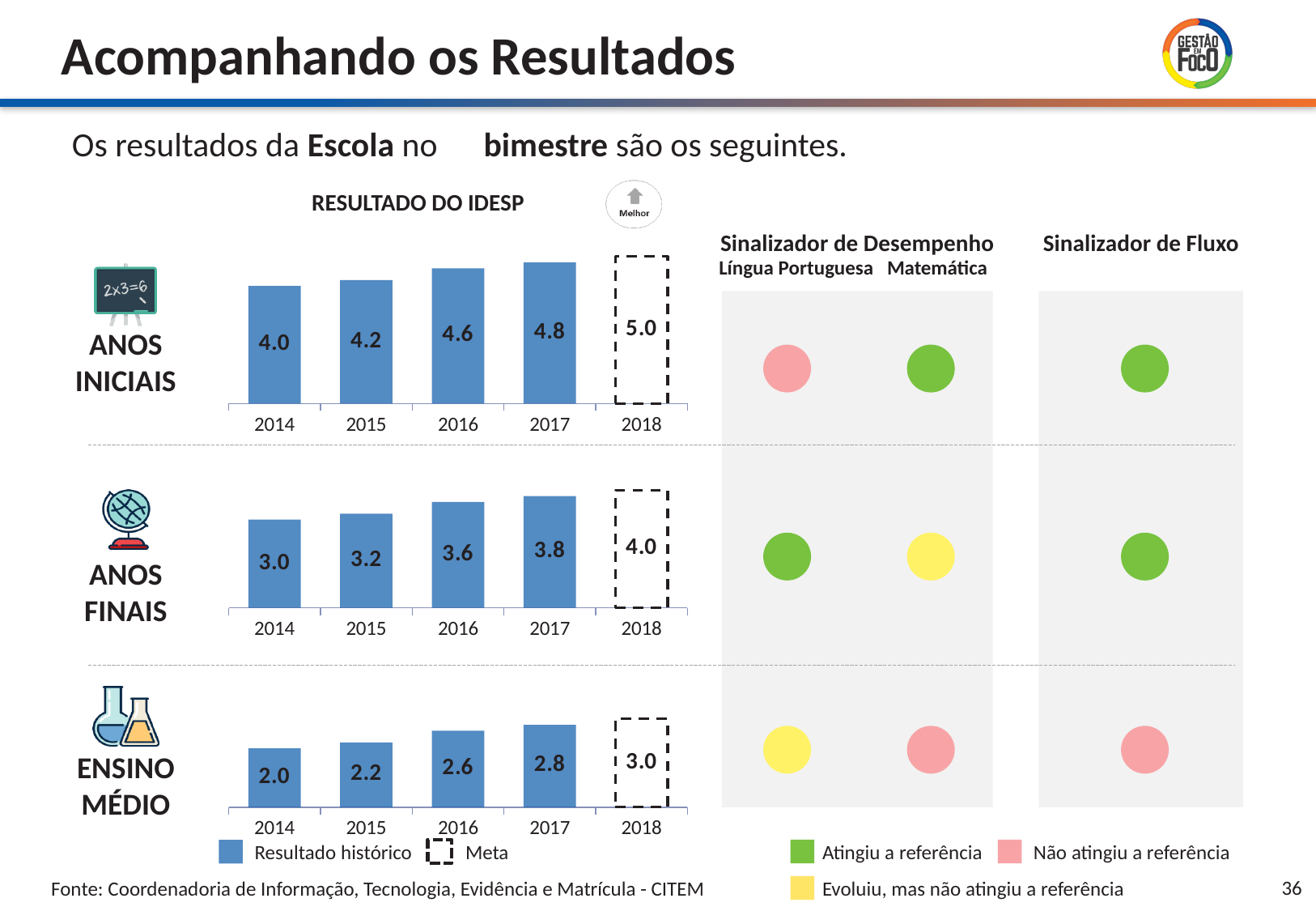
In the ANOS FINAIS chart, do the historical results rise or fall from 2014 to 2017? Rise In the ANOS FINAIS chart, what is the difference between the 2017 result and the 2014 result? 0.8 What type of chart is used to show the RESULTADO DO IDESP for each school level? Bar chart In the ENSINO MÉDIO chart, what is the IDESP result for 2014? 2.0 In the ANOS INICIAIS chart, what is the IDESP result for 2016? 4.6 In the ANOS INICIAIS chart, what is the difference between the 2018 target and the 2017 result? 0.2 In the ANOS INICIAIS chart, which year has the highest historical result (excluding the 2018 target)? 2017 Which is larger: the 2016 value in the ANOS FINAIS chart or the 2017 value in the ENSINO MÉDIO chart? 2016 value in ANOS FINAIS (3.6) What do the dashed bars in the charts represent, according to the legend? Meta How many years are shown on the x axis of the ENSINO MÉDIO chart? 5 In the ENSINO MÉDIO chart, which year has the lowest value? 2014 In the ANOS FINAIS chart, what is the 2018 target (Meta) value? 4.0